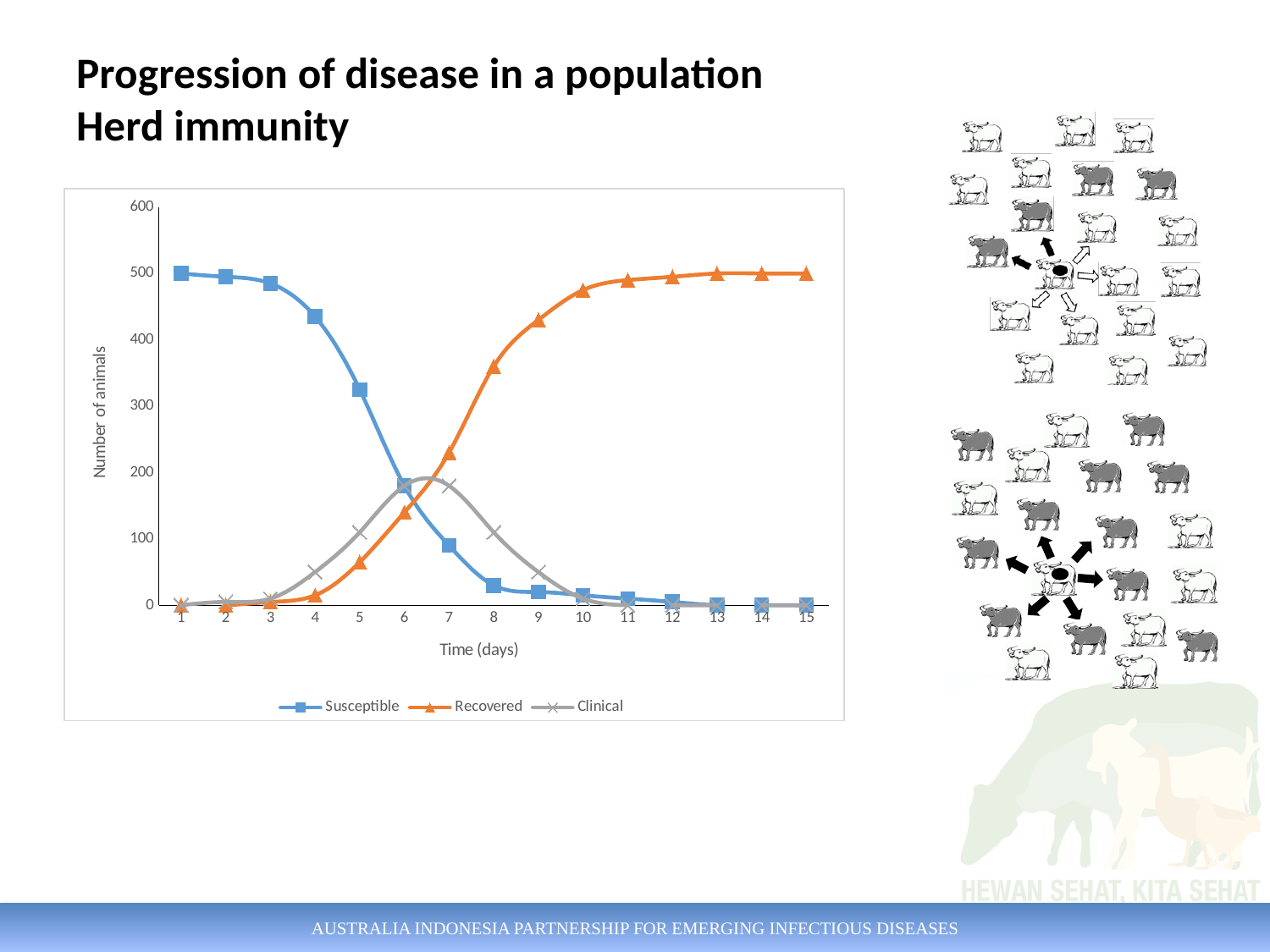
Does the Recovered series rise or fall as time increases from day 1 to day 15? rise At day 9, which series has the larger value, Recovered or Susceptible? Recovered What is the title of the chart's y axis? Number of animals Does the Susceptible series rise or fall as time increases from day 1 to day 15? fall At day 3, which series has the larger value, Susceptible or Recovered? Susceptible How many time points (days) are plotted along the x axis? 15 Is the value for Susceptible at day 5 greater or less than 200? greater What kind of chart is shown on the slide? line chart Is the value for Clinical at day 7 greater or less than 300? less How many series does the chart legend list? 3 Is the value for Susceptible at day 1 greater or less than 400? greater